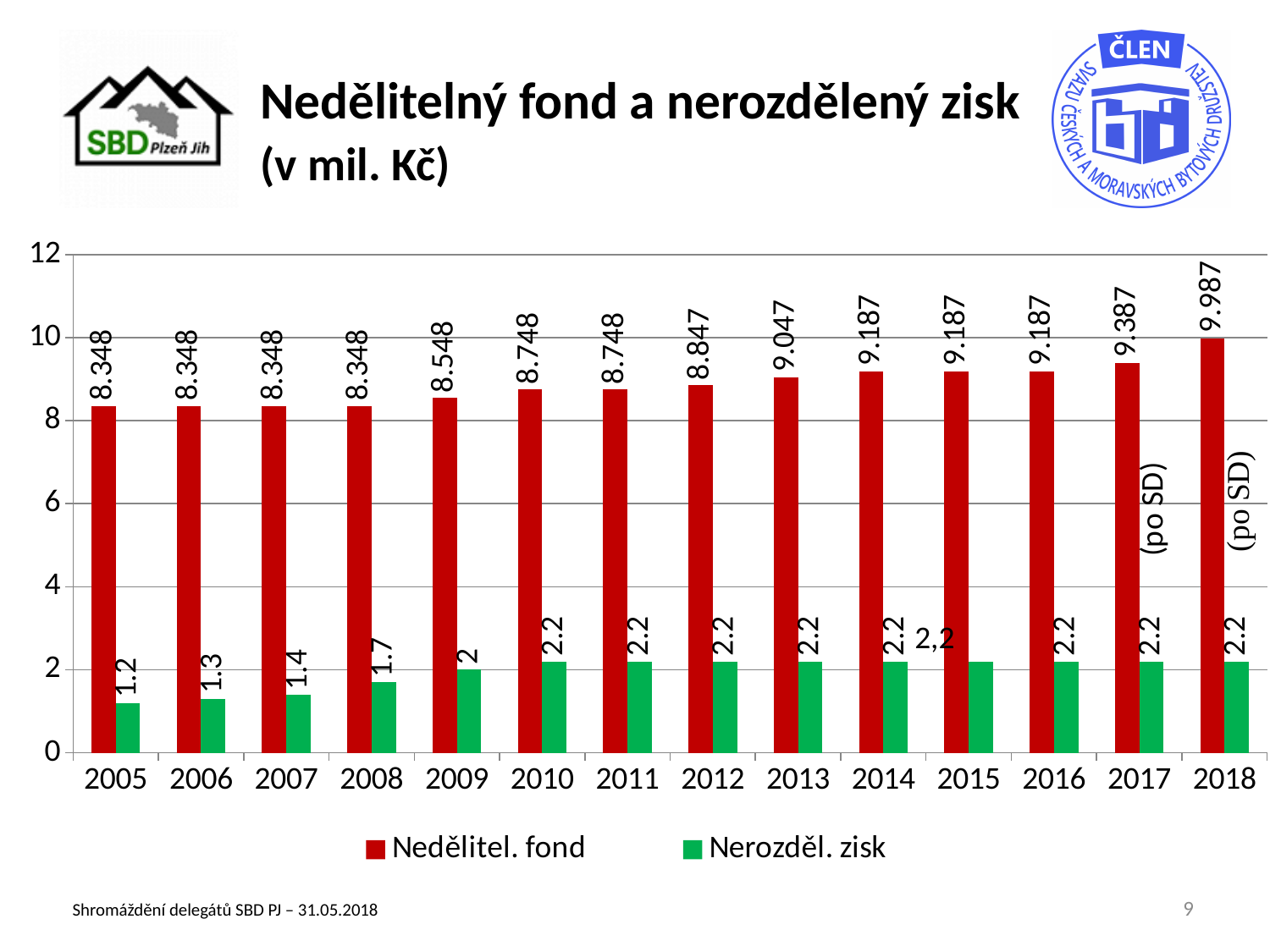
What is the value of Nedělitel. fond for 2018? 9.987 What is the value of Nerozděl. zisk for 2008? 1.7 In which year is Nerozděl. zisk lowest? 2005 What is the difference between Nedělitel. fond in 2018 and in 2017? 0.6 What is the value of Nerozděl. zisk for 2005? 1.2 Is the value of Nedělitel. fond for 2012 greater or less than 8? greater What is the value of Nedělitel. fond for 2013? 9.047 Which is larger: Nerozděl. zisk in 2009 or in 2010? 2010 How many years are shown on the x axis? 14 In which year is Nedělitel. fond highest? 2018 What kind of chart is shown on the slide? bar chart How many series does the legend list? 2